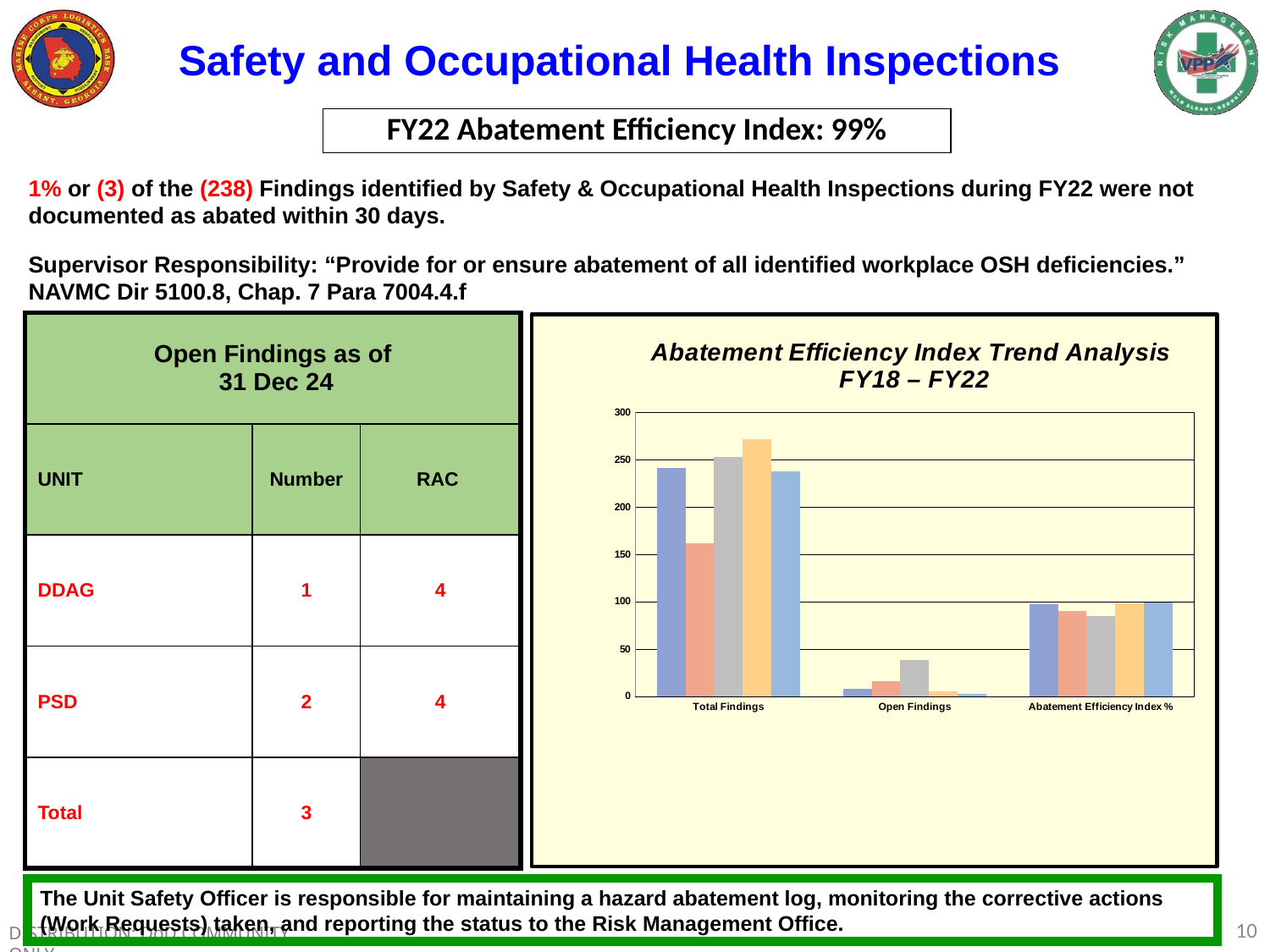
In the Abatement Efficiency Index Trend Analysis chart, is the tallest bar for Open Findings greater or less than 50? less In the Abatement Efficiency Index Trend Analysis chart, which category has the shortest bars? Open Findings In the Abatement Efficiency Index Trend Analysis chart, which is larger: the first bar for Total Findings or the first bar for Abatement Efficiency Index %? Total Findings What fiscal year range does the title of the Abatement Efficiency Index Trend Analysis chart cover? FY18 – FY22 In the Abatement Efficiency Index Trend Analysis chart, is the second bar for Total Findings greater or less than 200? less What is the highest value shown on the y axis of the Abatement Efficiency Index Trend Analysis chart? 300 In the Abatement Efficiency Index Trend Analysis chart, is the first (leftmost) bar for Total Findings greater or less than 200? greater In the Abatement Efficiency Index Trend Analysis chart, which category has the tallest bars? Total Findings How many categories are shown on the x axis of the Abatement Efficiency Index Trend Analysis chart? 3 What kind of chart is the Abatement Efficiency Index Trend Analysis chart? bar chart How many bars are plotted in the Total Findings group of the Abatement Efficiency Index Trend Analysis chart? 5